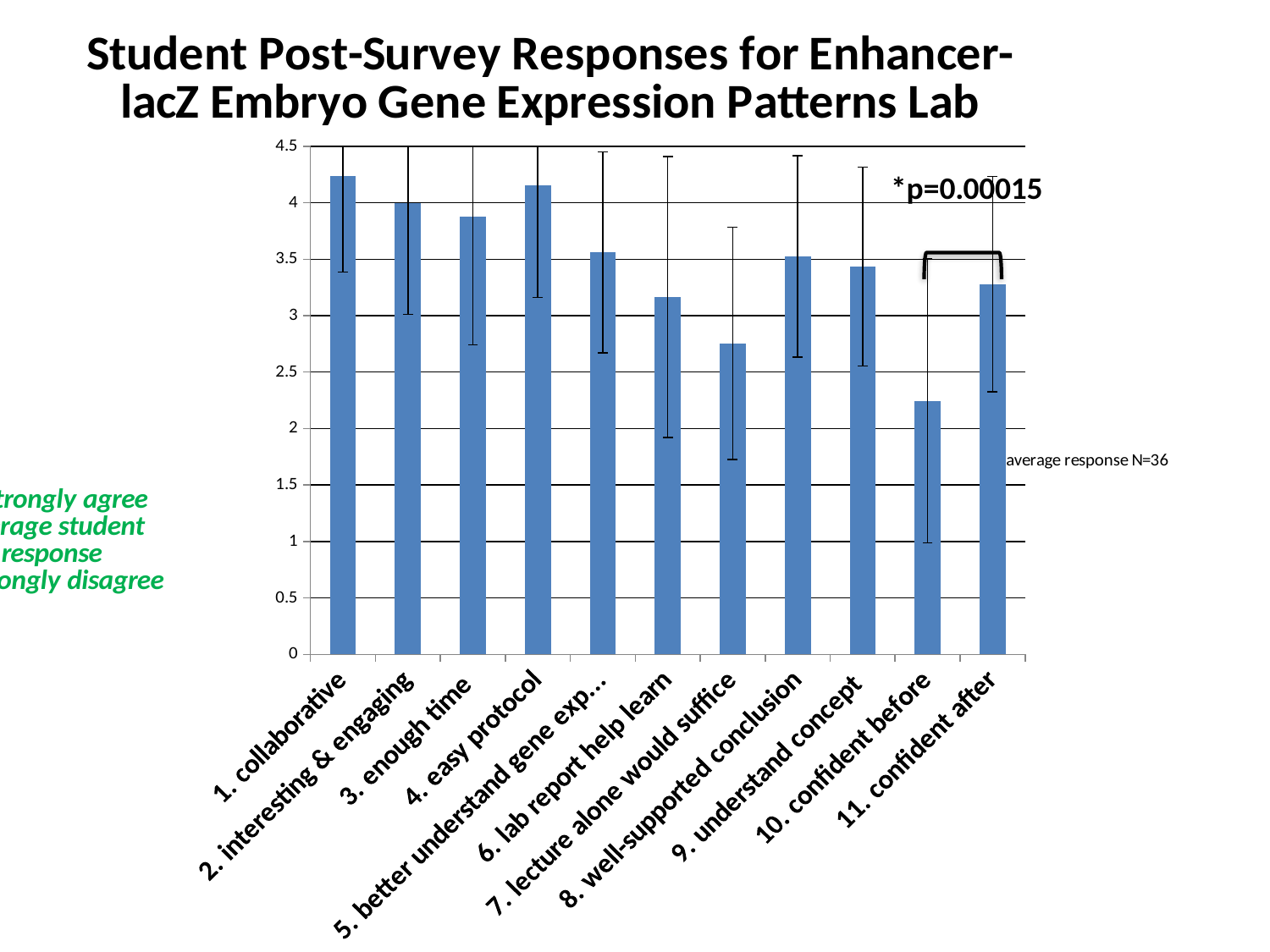
What sample size (N) is given in the chart's legend? N=36 Is the value for '7. lecture alone would suffice' greater or less than 3? less What p-value is annotated on the chart? p=0.00015 Which is larger, the value for '7. lecture alone would suffice' or '8. well-supported conclusion'? 8. well-supported conclusion Is the value for '3. enough time' greater or less than 3.5? greater Is the value for '1. collaborative' greater or less than 4? greater Which category has the lowest average response? 10. confident before Which is larger, the value for '10. confident before' or '11. confident after'? 11. confident after How many categories are plotted on the x axis of the chart? 11 What kind of chart is shown on the slide? bar chart